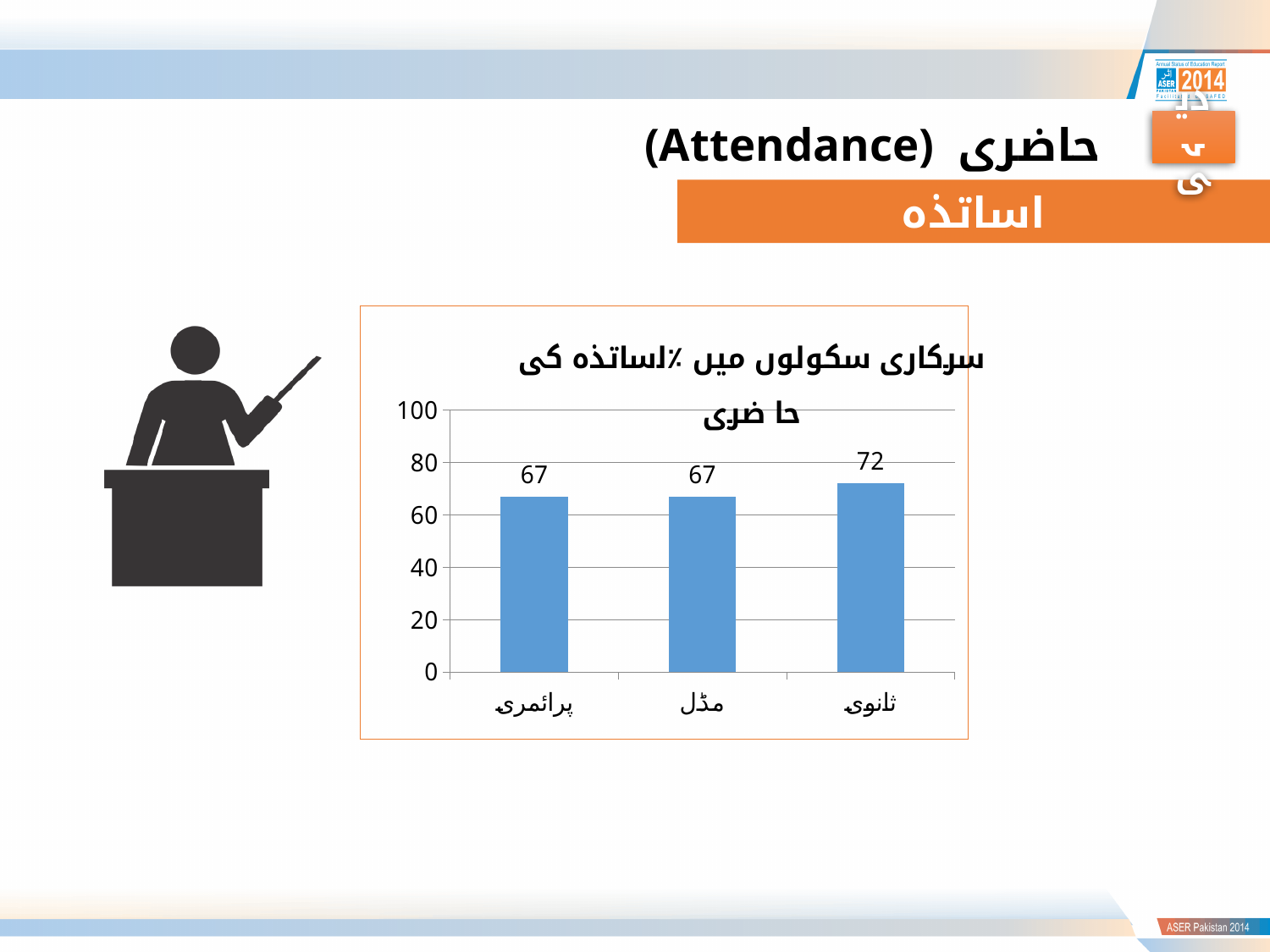
What is the value for ثانوی (Secondary) in the bar chart? 72 What is the value for پرائمری (Primary) in the bar chart? 67 What is the value for مڈل (Middle) in the bar chart? 67 Is the value for ثانوی (Secondary) greater or less than 80? less What kind of chart is shown on the slide? bar chart Is the value for پرائمری (Primary) greater or less than 60? greater Which category has the highest value in the bar chart? ثانوی (Secondary) What colour are the bars in the chart? blue What is the maximum value shown on the vertical axis of the bar chart? 100 Which is larger, the value for ثانوی (Secondary) or the value for پرائمری (Primary)? ثانوی (Secondary) What is the difference between the values for ثانوی (Secondary) and مڈل (Middle)? 5 How many categories are plotted in the bar chart? 3